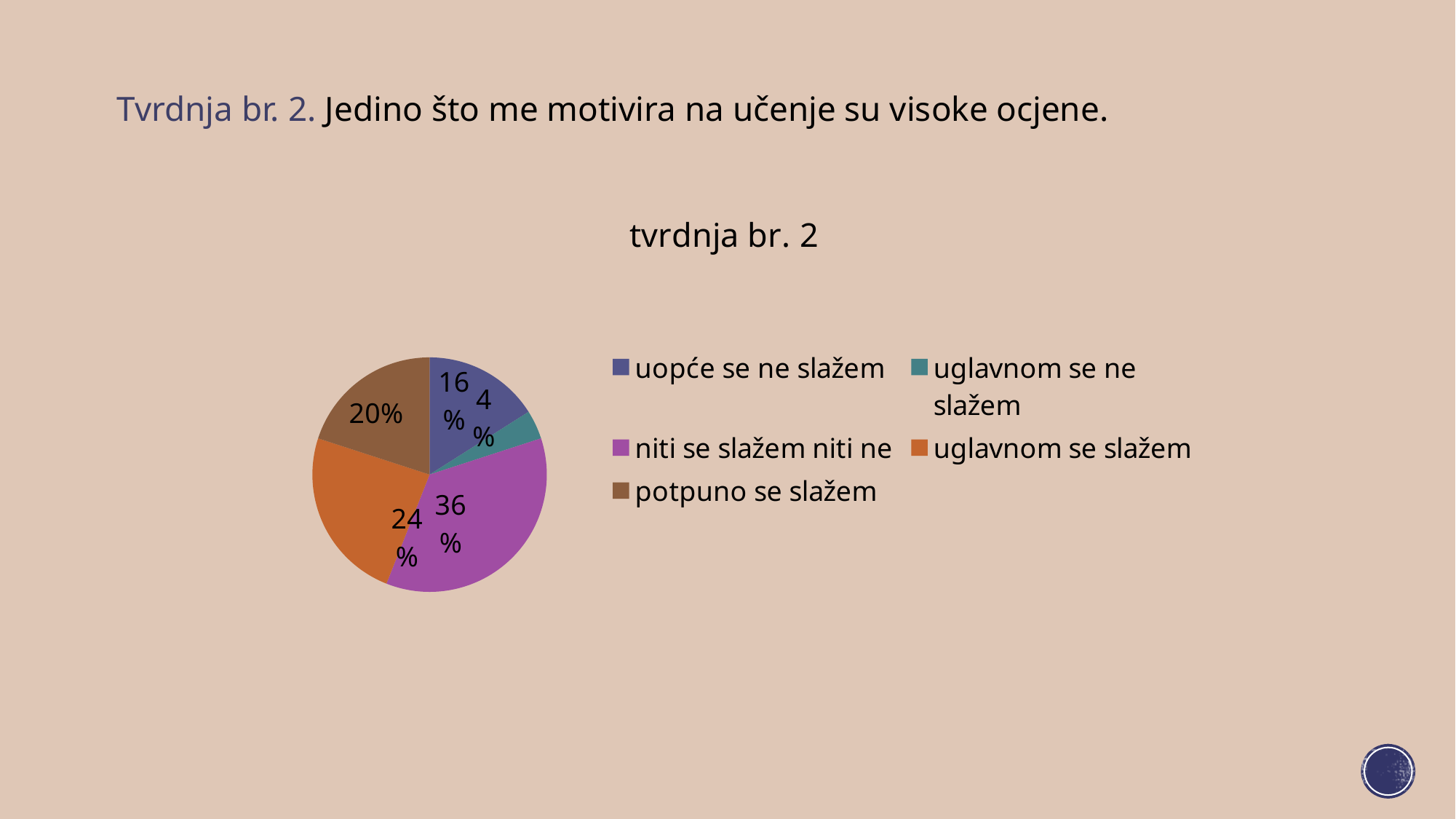
What share of the pie does 'uglavnom se ne slažem' have? 4% What share of the pie does 'potpuno se slažem' have? 20% What is the title of the chart? tvrdnja br. 2 What share of the pie does 'niti se slažem niti ne' have? 36% What kind of chart is shown on the slide? pie chart Which is larger, the share for 'uglavnom se slažem' or the share for 'potpuno se slažem'? uglavnom se slažem What is the difference between the shares of 'niti se slažem niti ne' and 'uglavnom se slažem'? 12% Which category has the largest slice of the pie? niti se slažem niti ne Which category has the smallest slice of the pie? uglavnom se ne slažem How many categories does the legend list? 5